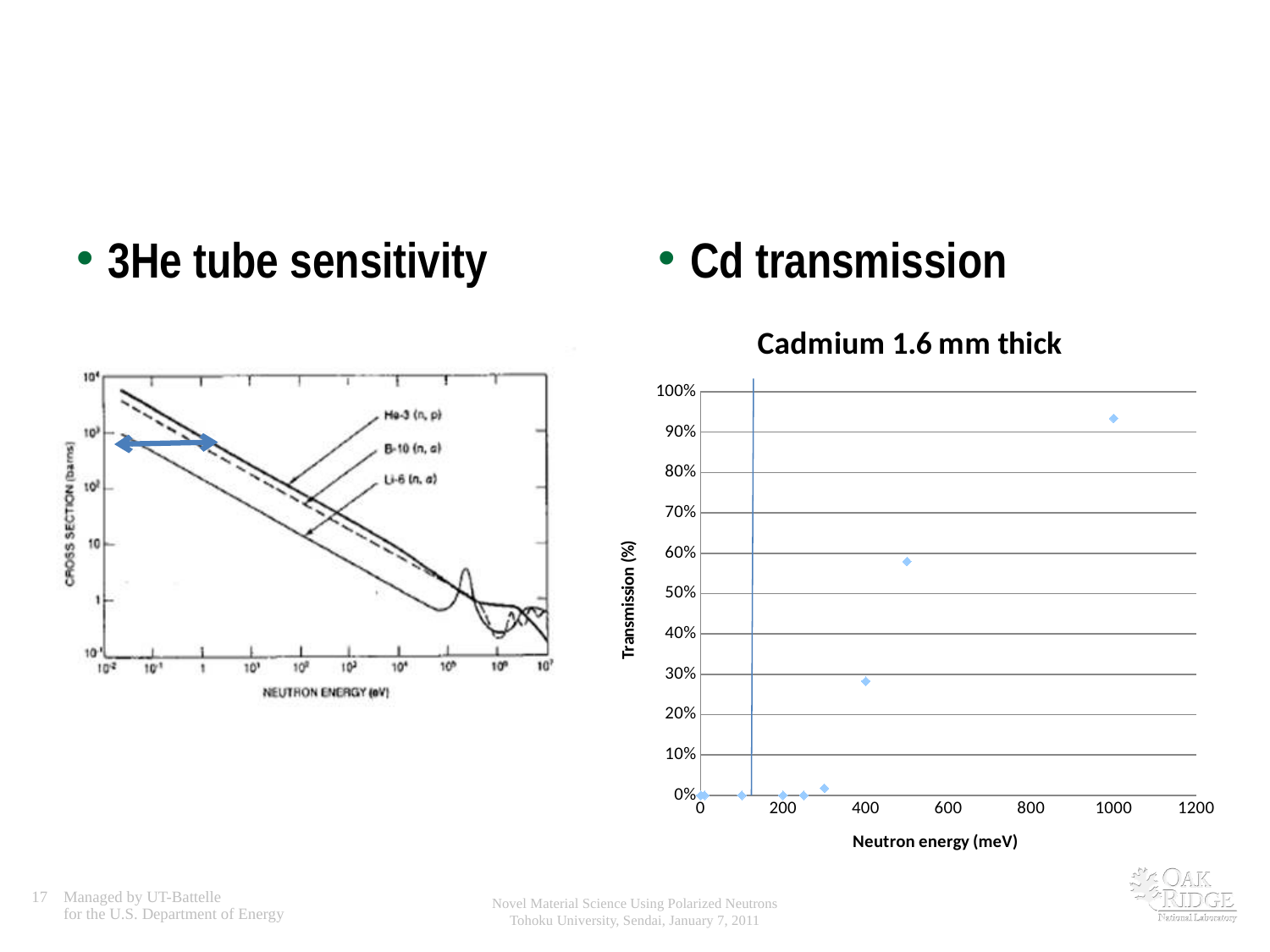
In the Cadmium 1.6 mm thick chart, does transmission rise or fall as neutron energy increases? rise In the Cadmium 1.6 mm thick chart, is the transmission higher at 500 meV or at 1000 meV? 1000 meV In the Cadmium 1.6 mm thick chart, is the transmission at 400 meV greater or less than 40%? less In the 3He tube sensitivity chart on the left, does the He-3 (n, p) cross section rise or fall as neutron energy increases? fall In the Cadmium 1.6 mm thick chart, what is the label of the y axis? Transmission (%) In the Cadmium 1.6 mm thick chart, is the transmission at 500 meV greater or less than 50%? greater What is the title of the chart on the right side of the slide? Cadmium 1.6 mm thick What kind of chart is the 3He tube sensitivity chart on the left? line chart What kind of chart is the Cadmium 1.6 mm thick chart? scatter chart In the Cadmium 1.6 mm thick chart, which neutron energy has the highest transmission? 1000 meV In the Cadmium 1.6 mm thick chart, is the transmission at 300 meV greater or less than 10%? less